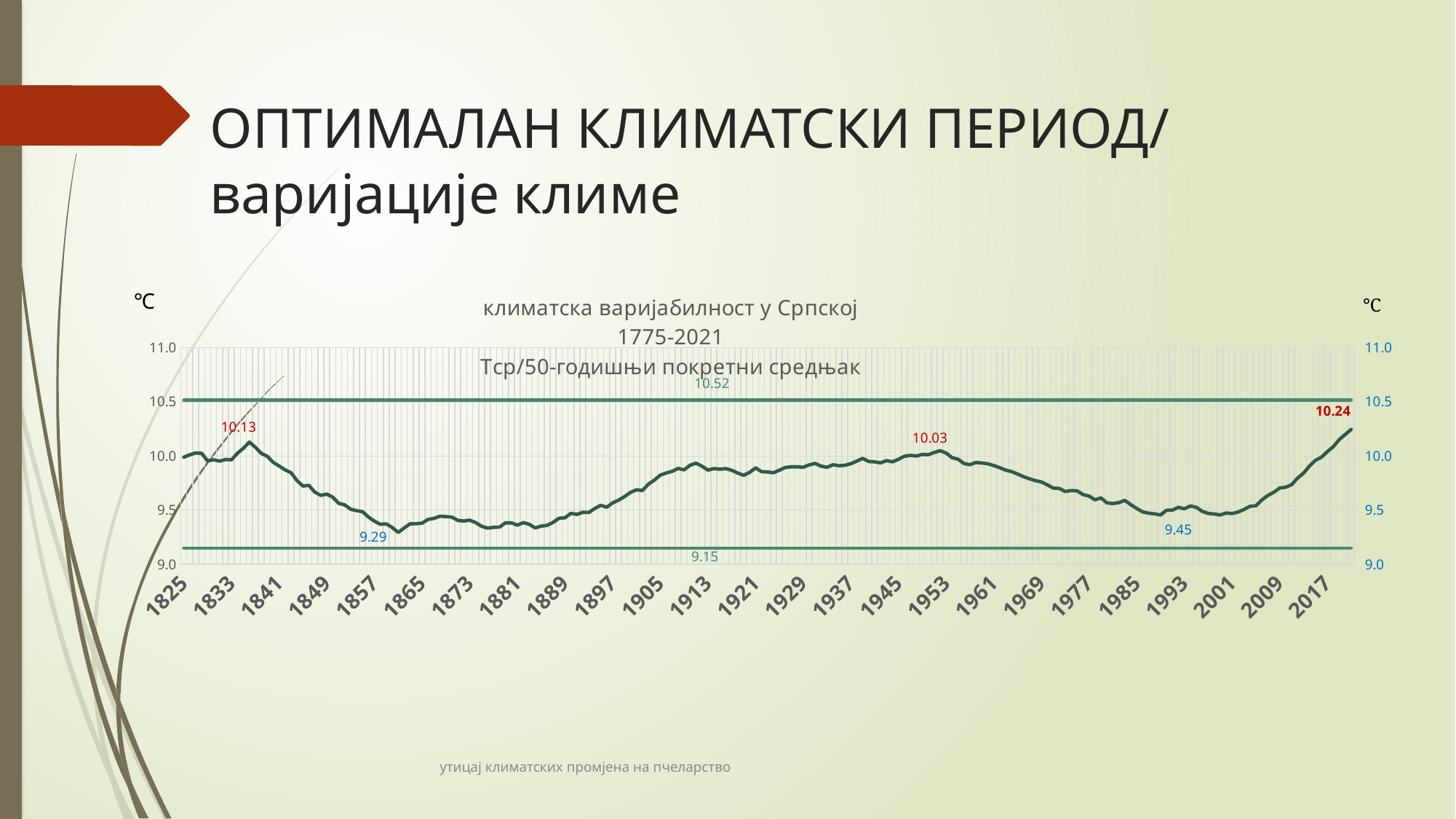
What is the value of the labelled peak near 1953 on the chart? 10.03 What kind of chart is shown on the slide? line chart What is the difference between the upper reference line (10.52) and the lower reference line (9.15)? 1.37 What is the value labelled at the right end of the line (around 2021)? 10.24 What is the value of the labelled low point near 1989 on the chart? 9.45 What is the value of the labelled peak near 1837 on the chart? 10.13 What is the value of the lower horizontal reference line on the chart? 9.15 What is the value of the upper horizontal reference line on the chart? 10.52 What is the period given in the chart title? 1775-2021 Does the line rise or fall between 2001 and 2017? rise What is the value of the labelled low point near 1861 on the chart? 9.29 Which is larger, the labelled peak near 1837 or the labelled peak near 1953? the peak near 1837 (10.13)